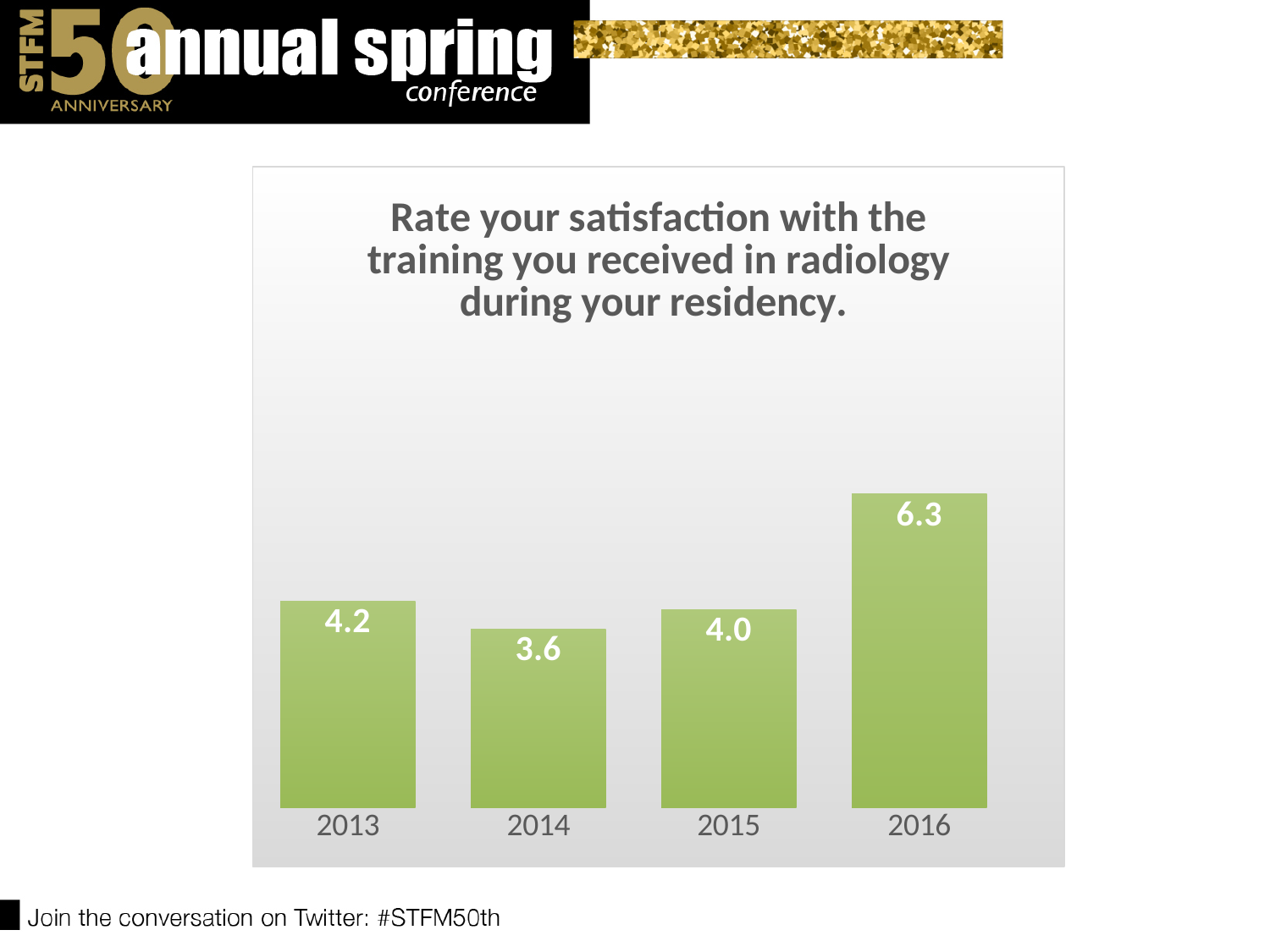
What is the value for 2015? 4.0 Which year has the highest value? 2016 Which is larger, the value for 2013 or the value for 2015? 2013 What is the value for 2016? 6.3 What is the difference between the values for 2016 and 2013? 2.1 How many years are shown on the chart? 4 What is the value for 2013? 4.2 What is the difference between the values for 2015 and 2014? 0.4 What kind of chart is shown? Bar chart What is the value for 2014? 3.6 Which year has the lowest value? 2014 What is the title of the chart? Rate your satisfaction with the training you received in radiology during your residency.